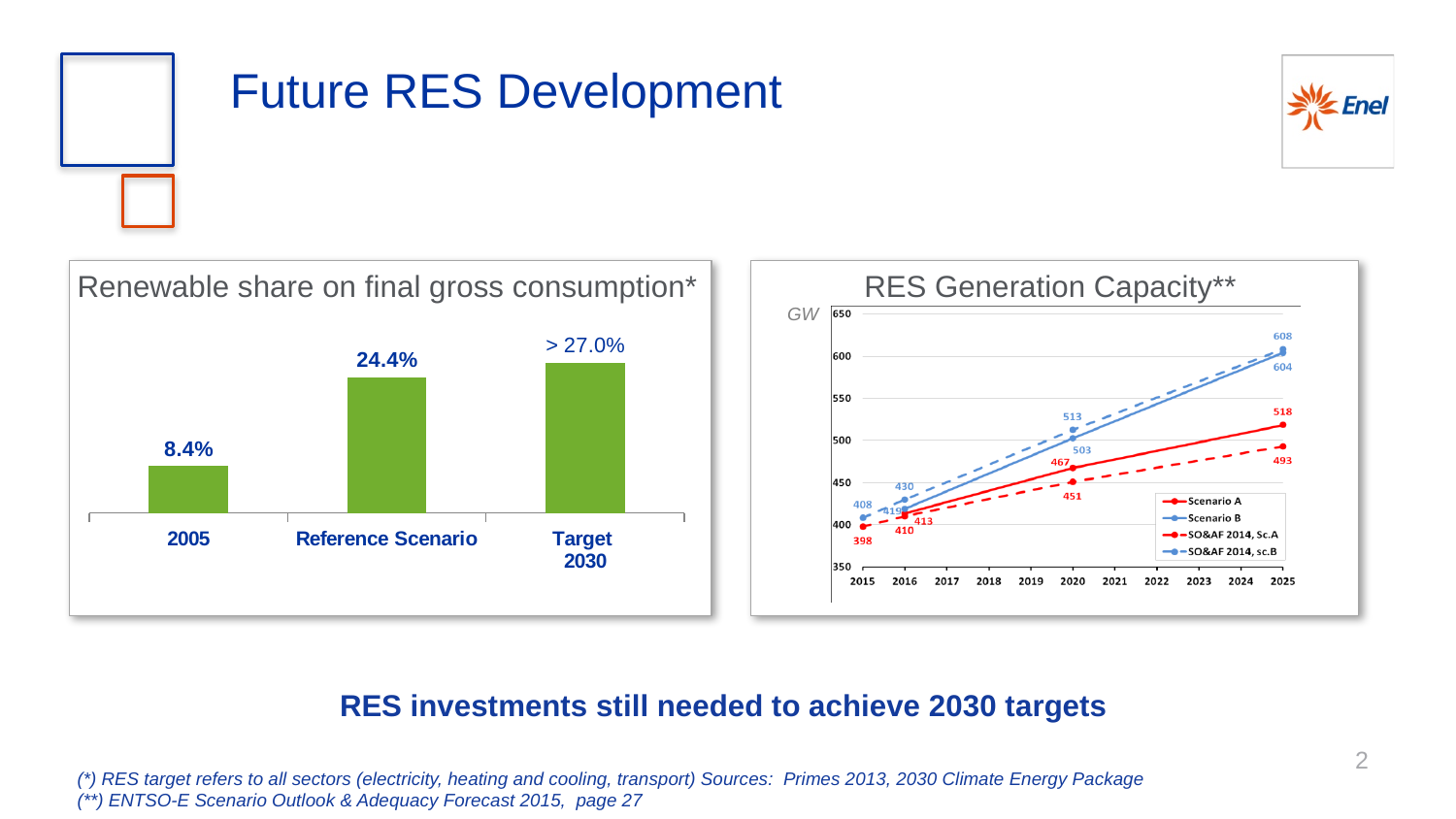
In the 'RES Generation Capacity**' chart, how many series does the legend list? 4 In the 'Renewable share on final gross consumption*' chart, what is the value for 2005? 8.4% In the 'Renewable share on final gross consumption*' chart, what is the value for the Reference Scenario? 24.4% In the 'RES Generation Capacity**' chart, what is the value for SO&AF 2014, Sc.A in 2025? 493 In the 'Renewable share on final gross consumption*' chart, what is the difference between the Reference Scenario and 2005 values? 16.0% In the 'Renewable share on final gross consumption*' chart, which category has the lowest value? 2005 In the 'RES Generation Capacity**' chart, what is the highest value shown in 2025? 608 In the 'RES Generation Capacity**' chart, what is the value for Scenario A in 2025? 518 What type of chart is 'Renewable share on final gross consumption*'? Bar chart In the 'Renewable share on final gross consumption*' chart, how many bars are shown? 3 In the 'RES Generation Capacity**' chart, do the values for Scenario B rise or fall from 2015 to 2025? Rise In the 'Renewable share on final gross consumption*' chart, what value is shown for Target 2030? > 27.0%